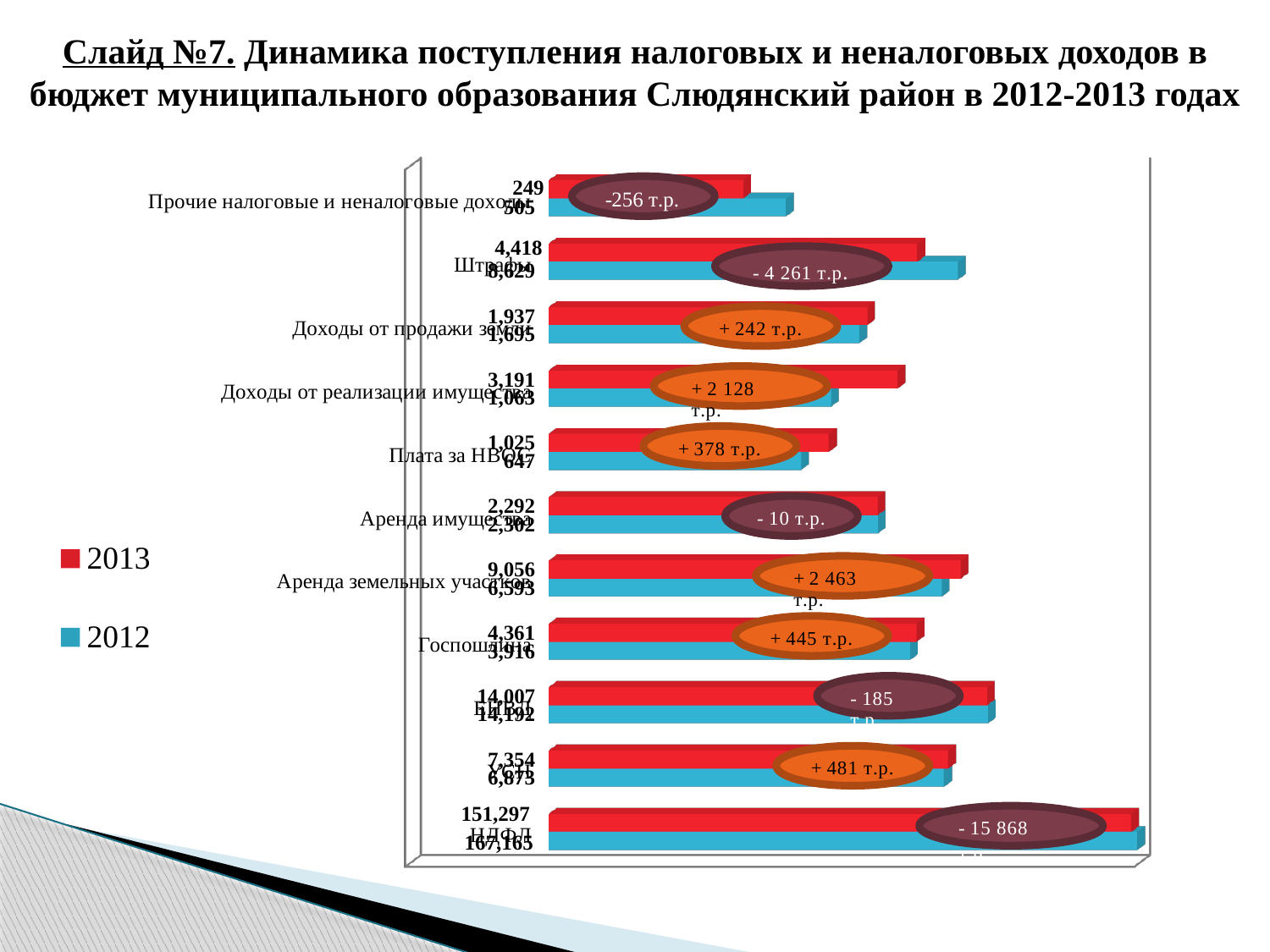
What kind of chart is shown on the slide? bar chart What is the difference between the 2013 and 2012 values for Плата за НВОС? 378 What is the 2012 value for НДФЛ? 167,165 Which category has the highest 2013 value? НДФЛ Which colour represents the 2013 series in the legend? red Which category has the lowest 2013 value? Прочие налоговые и неналоговые доходы What is the 2013 value for Аренда земельных участков? 9,056 What is the 2013 value for НДФЛ? 151,297 How many series does the legend list? 2 For Госпошлина, which year has the larger value, 2013 or 2012? 2013 How many categories are plotted on the chart? 11 What is the 2013 value for Доходы от реализации имущества? 3,191